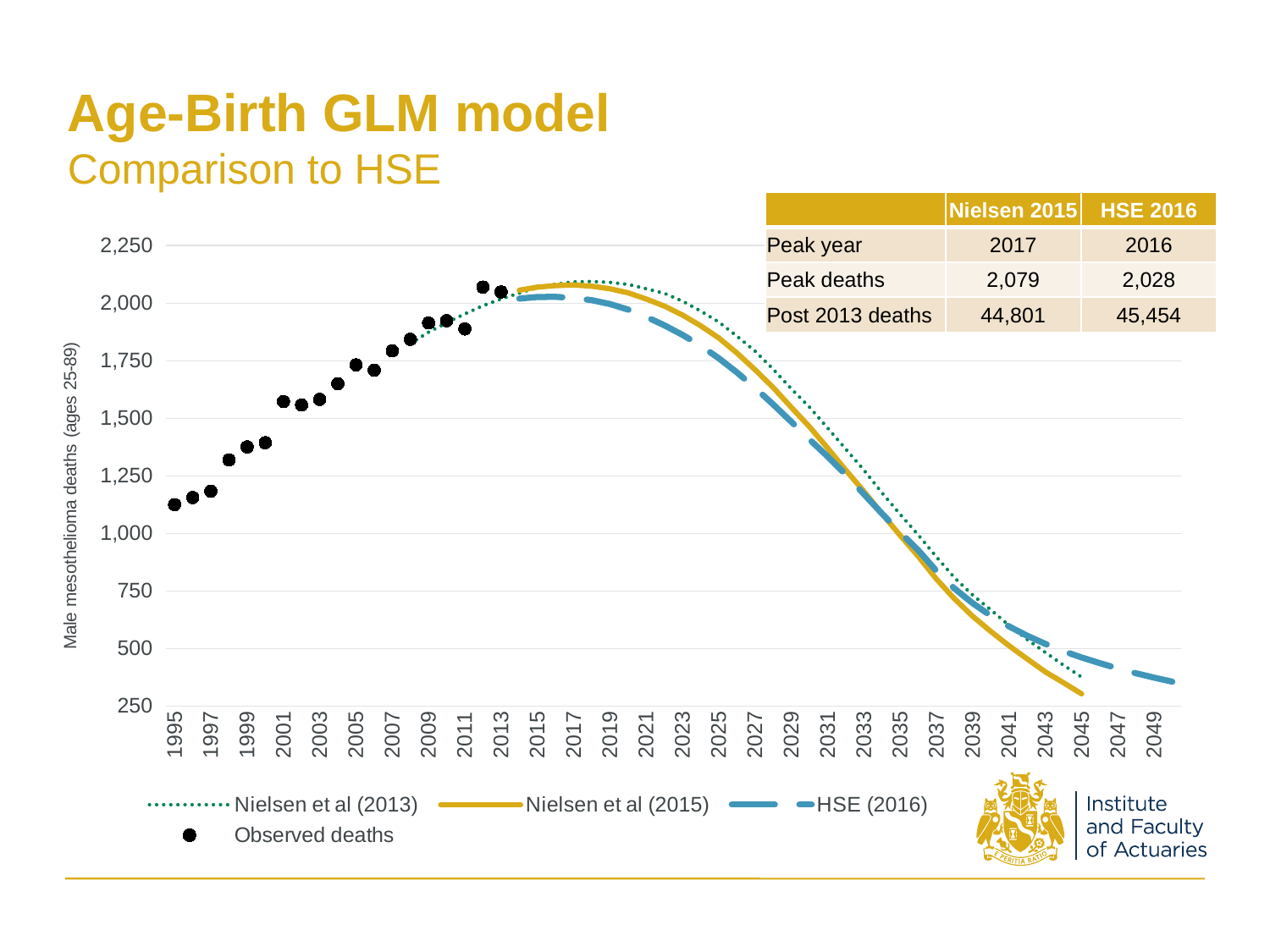
What kind of chart is shown on the slide? line chart In 2045, which projection is higher: HSE (2016) or Nielsen et al (2015)? HSE (2016) Which series in the legend is drawn as black dots? Observed deaths Do the observed deaths rise or fall between 1995 and 2013? rise According to the table on the slide, what is the peak year for Nielsen 2015? 2017 Is the observed deaths value for 1995 greater or less than 1,250? less How many series does the chart legend list? 4 Is the HSE (2016) projection for 2049 greater or less than 500? less Is the HSE (2016) projection for 2041 greater or less than 750? less According to the table on the slide, what is the difference in post 2013 deaths between HSE 2016 and Nielsen 2015? 653 What is the label of the vertical axis of the chart? Male mesothelioma deaths (ages 25-89)